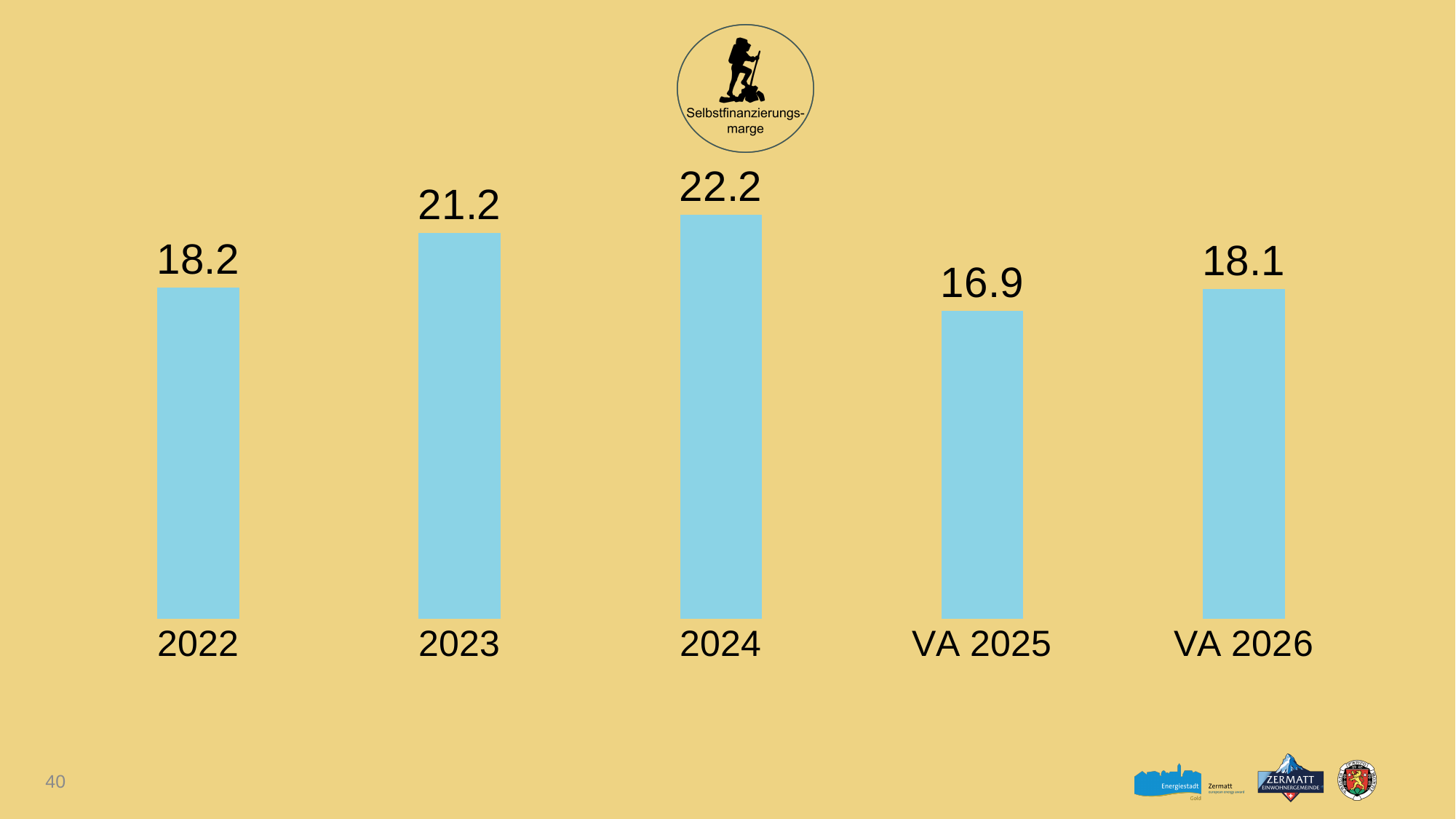
What is the difference between the values for 2023 and 2022? 3.0 What is the value for VA 2026? 18.1 Which is larger, the value for 2023 or the value for VA 2026? 2023 What is the value for VA 2025? 16.9 What is the difference between the values for 2024 and VA 2025? 5.3 What kind of chart is shown on the slide? Bar chart What is the title shown above the chart? Selbstfinanzierungsmarge What is the value for 2023? 21.2 How many categories are shown in the chart? 5 What is the value for 2022? 18.2 Which category has the lowest value? VA 2025 Which category has the highest value? 2024